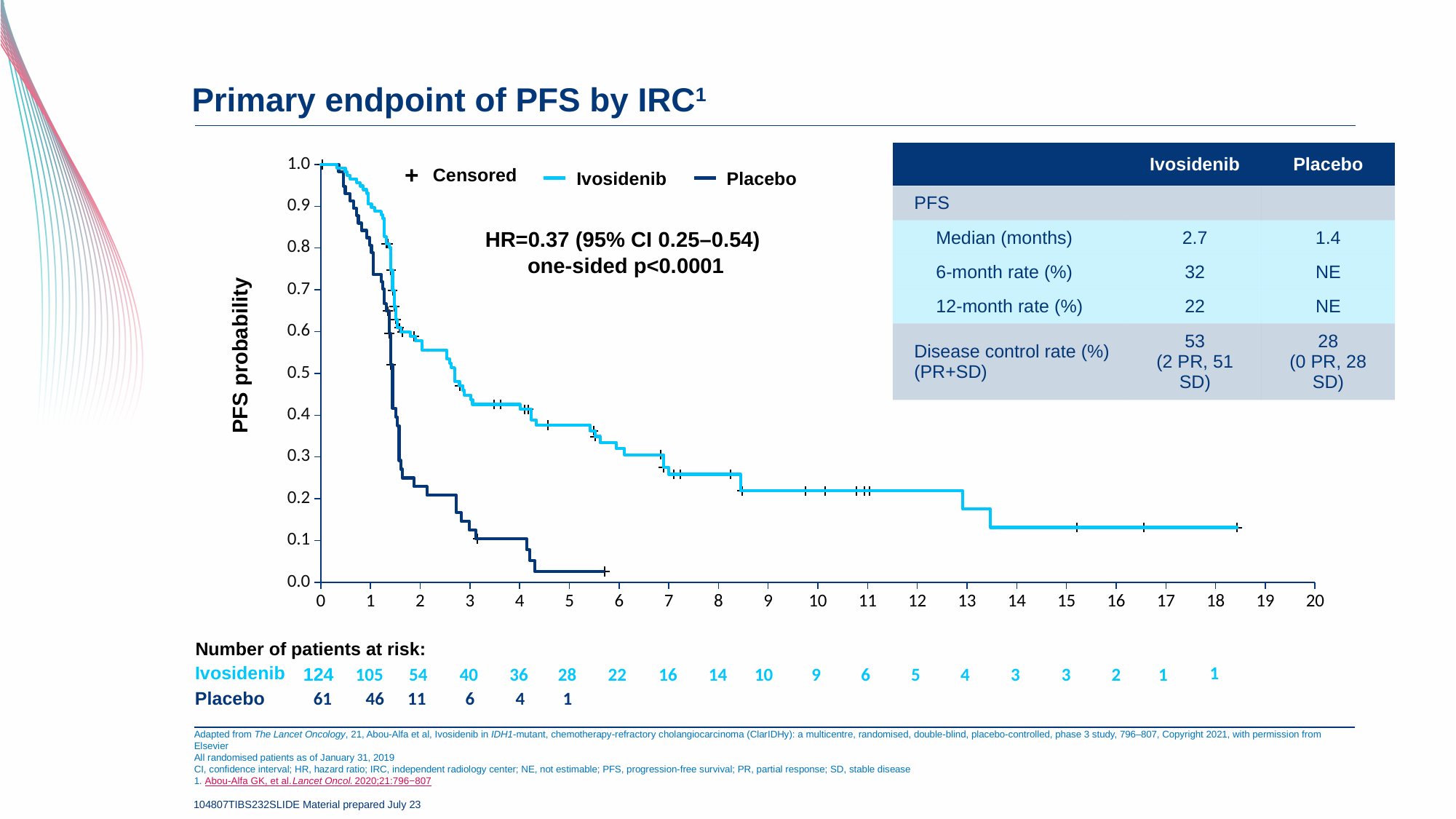
How many Placebo patients were at risk at month 1? 46 What is the difference between the number of Ivosidenib and Placebo patients at risk at month 0? 63 Do the PFS probability curves rise or fall as time increases along the x axis? fall How many Ivosidenib patients were at risk at month 0? 124 Is the Ivosidenib PFS probability at month 10 greater or less than 0.3? less What is the label of the y axis? PFS probability Is the Ivosidenib PFS probability at month 5 greater or less than 0.3? greater What hazard ratio is printed on the chart? HR=0.37 How many treatment groups are plotted as curves on the chart? 2 What kind of chart is shown on the slide? line chart At month 2, which curve shows the higher PFS probability, Ivosidenib or Placebo? Ivosidenib Is the Placebo PFS probability at month 3 greater or less than 0.2? less